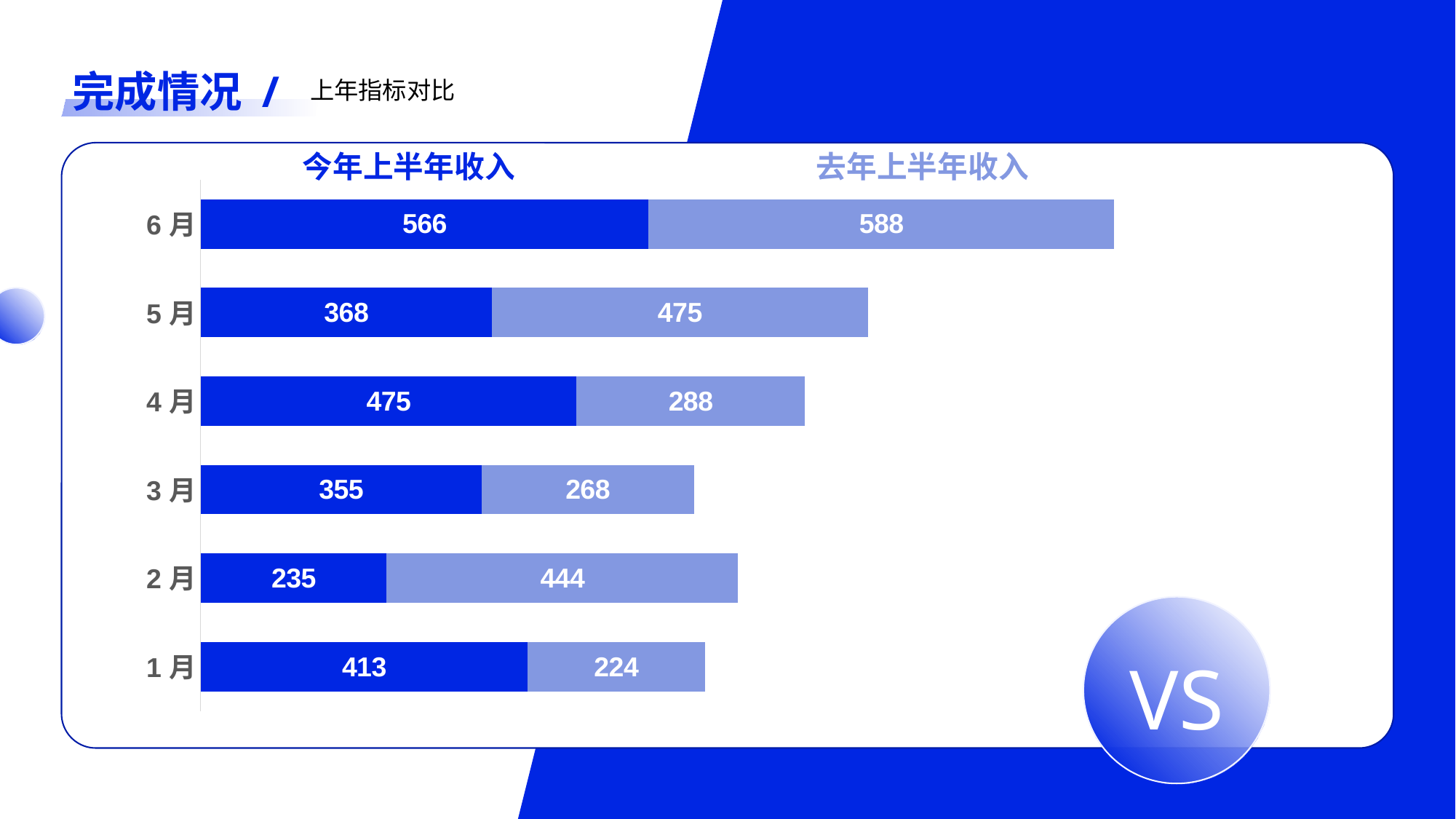
What is the 去年上半年收入 value for 2月? 444 Which month has the lowest 去年上半年收入 value? 1月 What is the 去年上半年收入 value for 1月? 224 For 4月, which is larger: 今年上半年收入 or 去年上半年收入? 今年上半年收入 Which month has the lowest 今年上半年收入 value? 2月 What kind of chart is shown on the slide? Stacked bar chart Which month has the highest 今年上半年收入 value? 6月 What is the total of the stacked bar for 6月? 1154 What is the difference between the 去年上半年收入 and 今年上半年收入 values for 5月? 107 How many series does the chart show? 2 How many months are shown on the chart? 6 What is the 今年上半年收入 value for 6月? 566